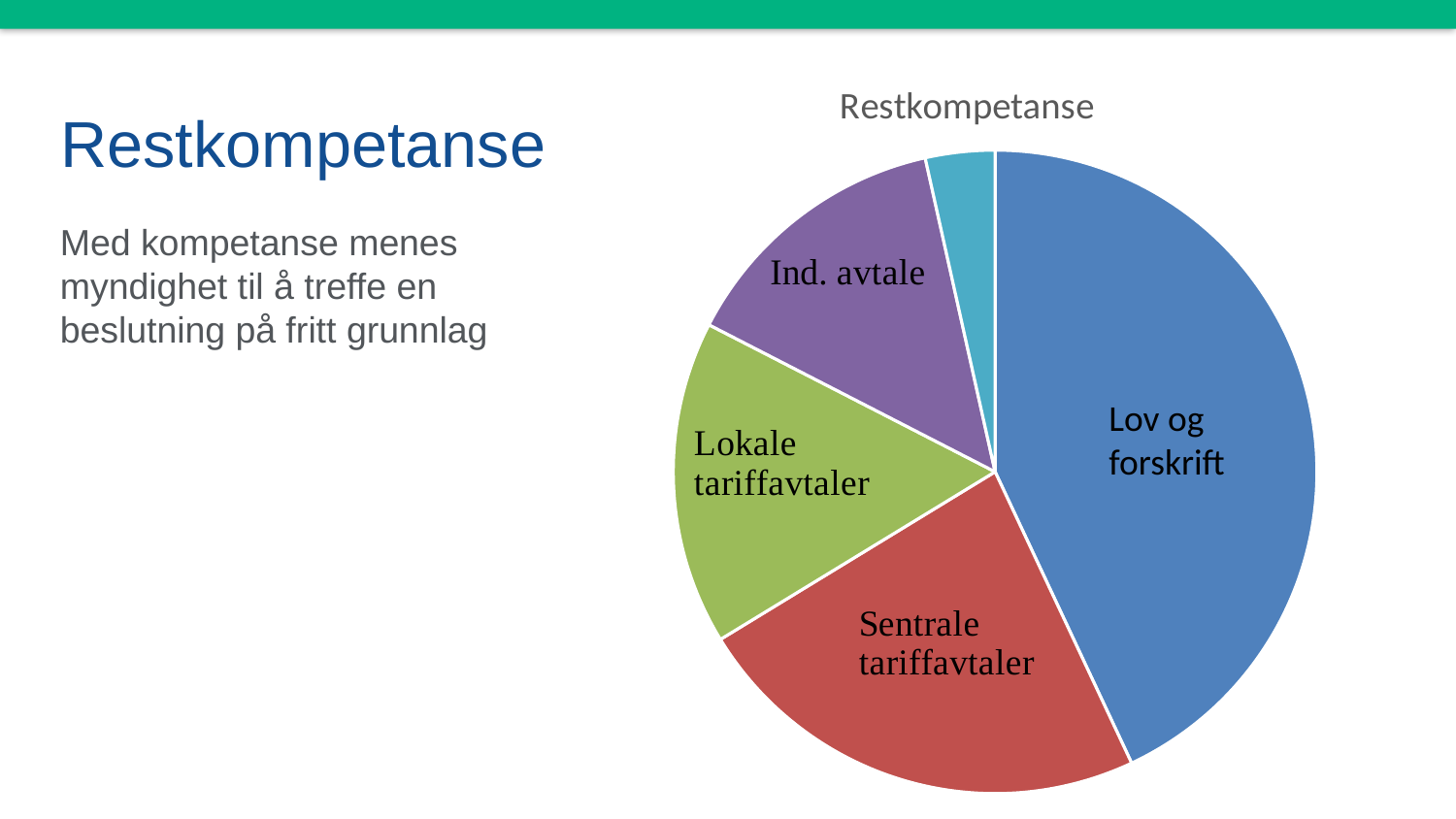
Which is larger, the slice for Lov og forskrift or the slice for Sentrale tariffavtaler? Lov og forskrift Which is larger, the slice for Lov og forskrift or the slice for Ind. avtale? Lov og forskrift What colour is the slice labelled Lov og forskrift? blue Which slice of the pie chart is the largest? Lov og forskrift How many slices does the pie chart have? 5 Which is larger, the slice for Sentrale tariffavtaler or the slice for Ind. avtale? Sentrale tariffavtaler What kind of chart is shown on the slide? pie chart What is the title of the chart? Restkompetanse